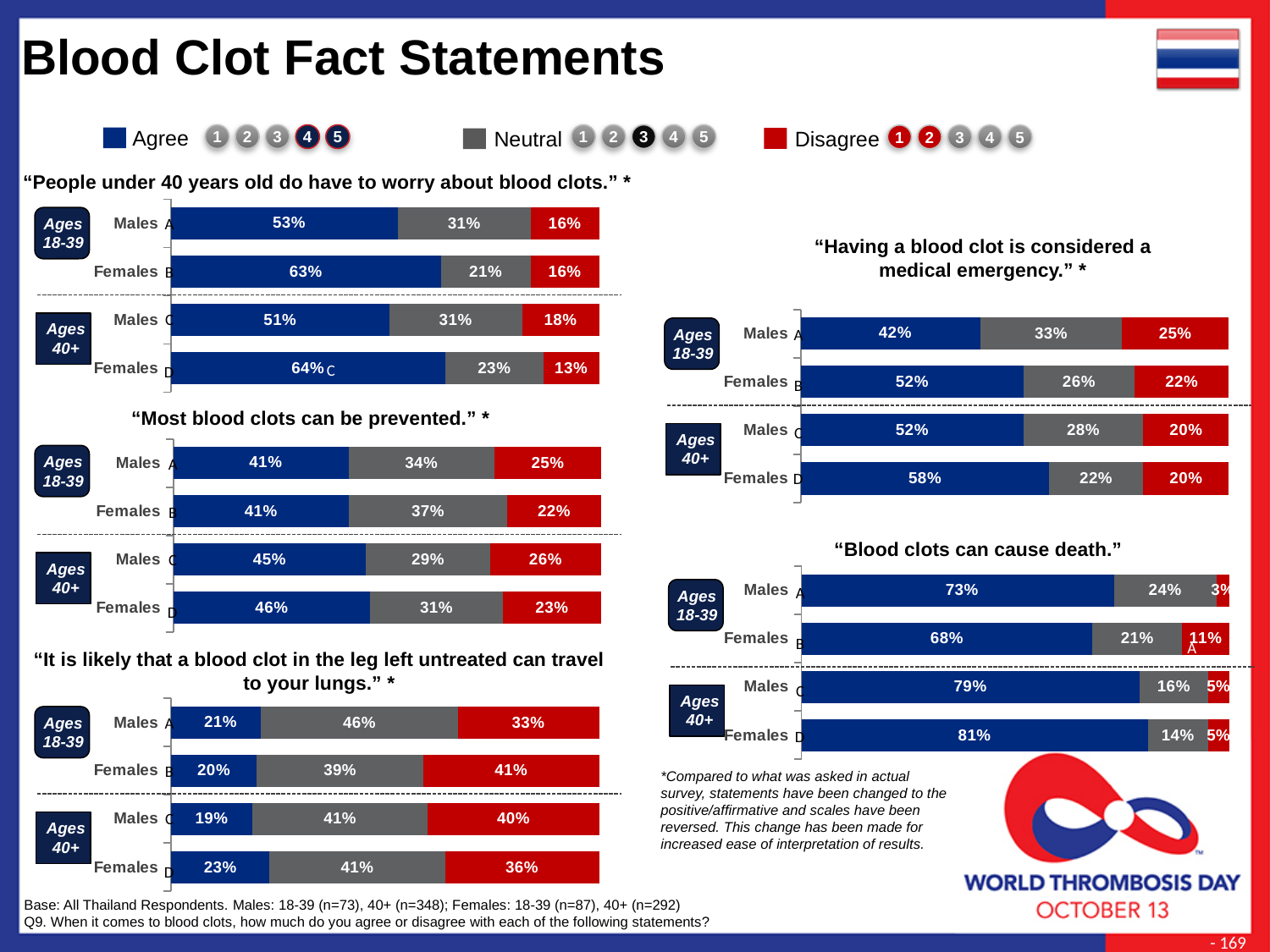
In the chart "People under 40 years old do have to worry about blood clots," which group has the highest Agree percentage? Females, Ages 40+ In the chart "Most blood clots can be prevented," what is the difference between the Disagree percentages for Males 40+ and Females 40+? 3% What type of chart is used for "Blood clots can cause death"? Stacked bar chart In the chart "It is likely that a blood clot in the leg left untreated can travel to your lungs," what percentage of Females aged 18-39 disagree? 41% In the chart "Blood clots can cause death," what is the difference between the Agree percentages for Males 18-39 and Males 40+? 6% In the chart "Blood clots can cause death," what percentage of Females aged 40+ agree? 81% In the chart "People under 40 years old do have to worry about blood clots," what percentage of Females aged 40+ agree? 64% In the chart "Having a blood clot is considered a medical emergency," which is larger: the Agree percentage for Females 18-39 or for Females 40+? Females 40+ In the chart "Having a blood clot is considered a medical emergency," what percentage of Males aged 18-39 agree? 42% How many series does the legend at the top of the slide list? 3 In the chart "It is likely that a blood clot in the leg left untreated can travel to your lungs," which group has the lowest Agree percentage? Males, Ages 40+ In the chart "Most blood clots can be prevented," what percentage of Females aged 18-39 are Neutral? 37%